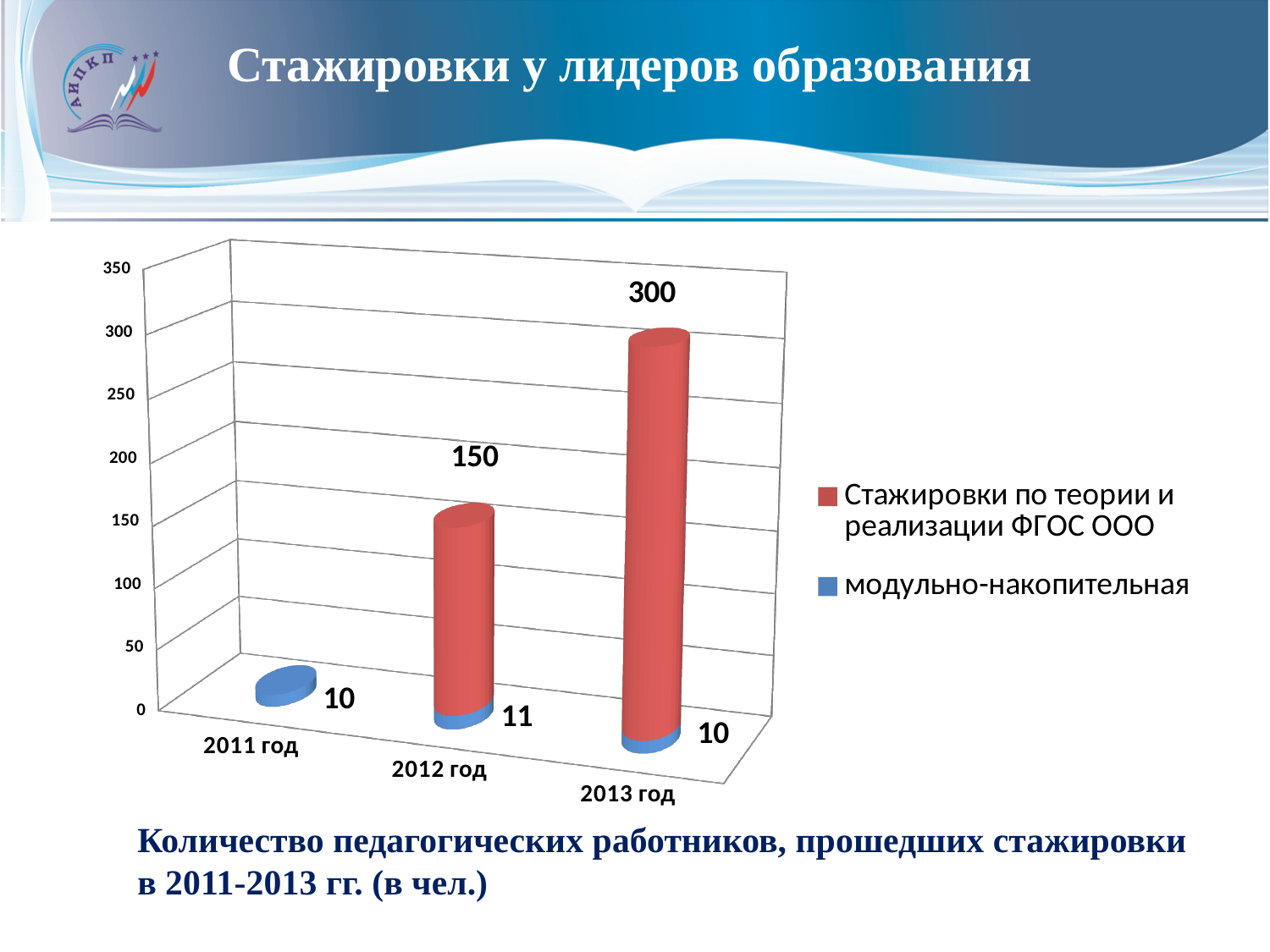
How many years are shown on the x axis? 3 What is the value for 'модульно-накопительная' in 2013 год? 10 What is the value for 'модульно-накопительная' in 2011 год? 10 What is the difference between the 'Стажировки по теории и реализации ФГОС ООО' values for 2013 год and 2012 год? 150 What kind of chart is shown on the slide? Stacked bar chart What is the total of the stacked bar for 2012 год? 161 What is the value for 'Стажировки по теории и реализации ФГОС ООО' in 2012 год? 150 What is the value for 'модульно-накопительная' in 2012 год? 11 What is the value for 'Стажировки по теории и реализации ФГОС ООО' in 2013 год? 300 What is the total of the stacked bar for 2013 год? 310 How many series does the legend list? 2 In which year is the value for 'Стажировки по теории и реализации ФГОС ООО' highest? 2013 год